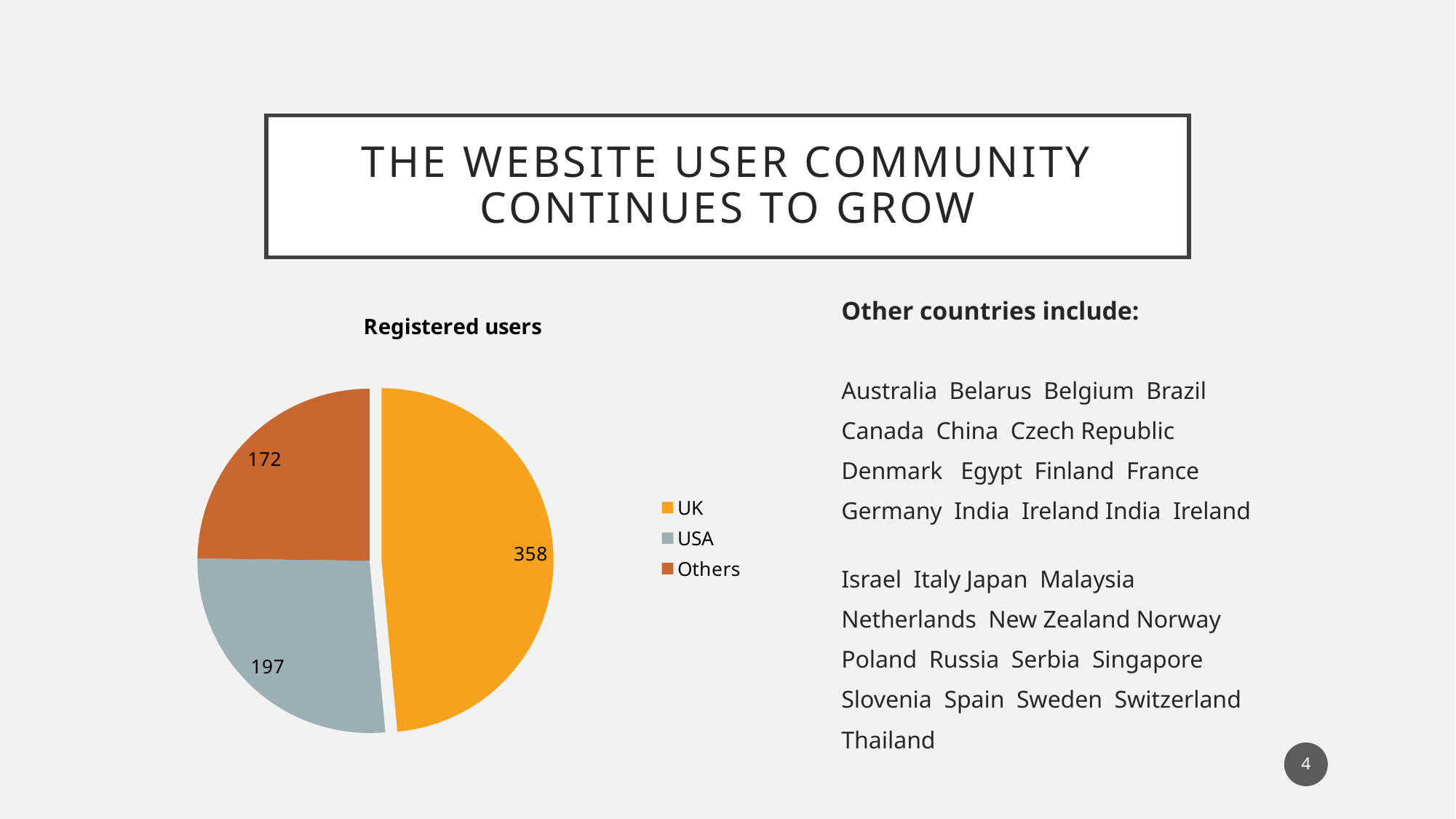
What type of chart is shown on the slide? Pie chart Which category has the smallest number of registered users? Others What is the title of the chart? Registered users How many categories does the pie chart show? 3 To the nearest whole percent, what share of registered users is from the UK? 49% What is the total number of registered users across all three slices? 727 How many registered users are from the UK? 358 What is the difference between the number of UK and USA registered users? 161 How many registered users are from the USA? 197 How many registered users are in the Others category? 172 Which has more registered users, USA or Others? USA Which category has the largest number of registered users? UK